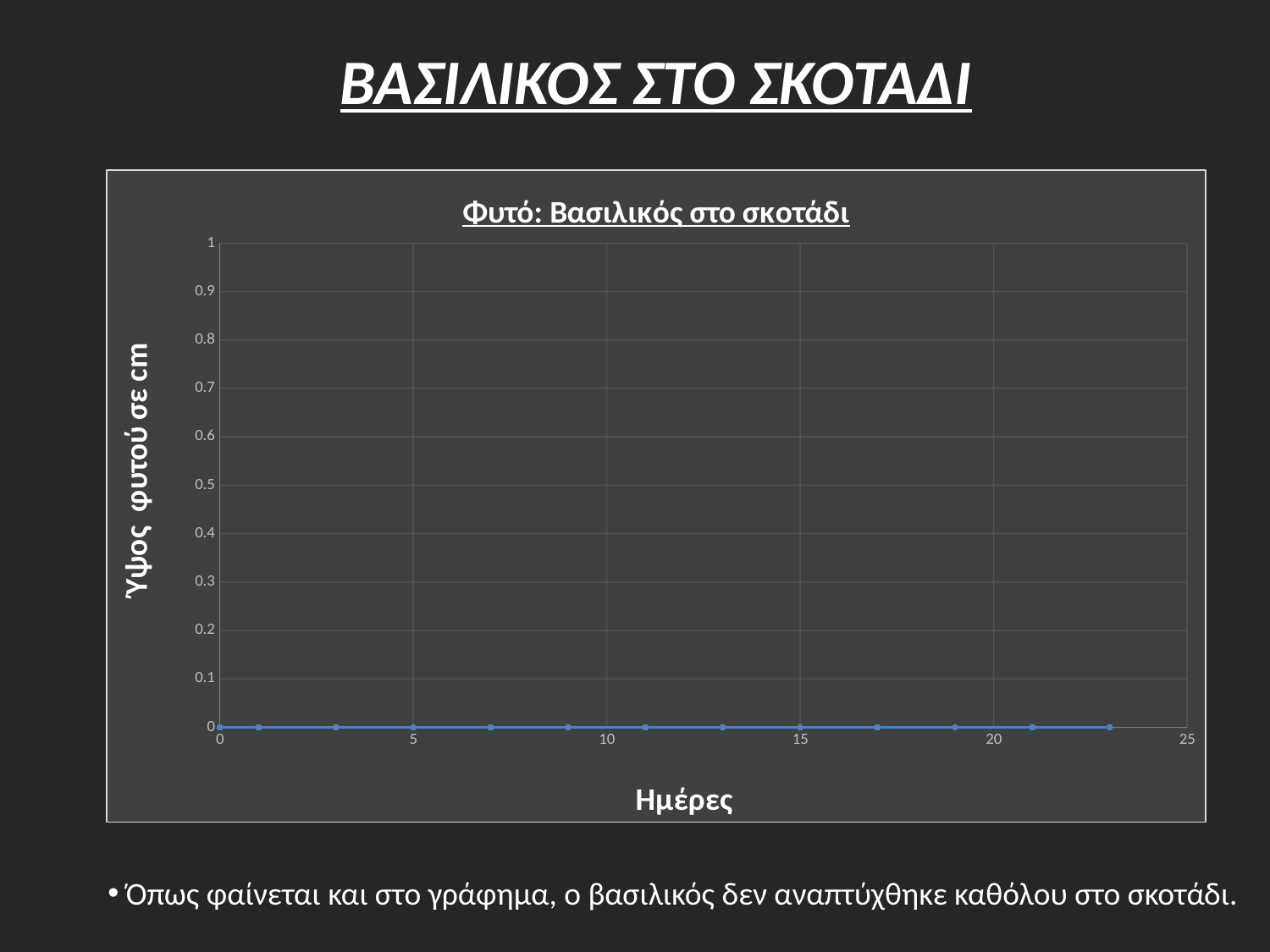
What is the difference between the plant height on day 20 and on day 0? 0 What is the plant height in cm on day 0? 0 What is the maximum value shown on the vertical axis? 1 Is the plant height on day 10 greater or less than 0.5 cm? less What is the plant height in cm on day 5? 0 What is the label of the vertical axis? Ύψος φυτού σε cm What is the plant height in cm on day 15? 0 What is the highest value reached by the plotted line? 0 Do the plotted values rise, fall, or stay flat as the days increase? stay flat What is the title of the chart? Φυτό: Βασιλικός στο σκοτάδι How many data points are plotted on the line? 13 What kind of chart is shown on the slide? line chart